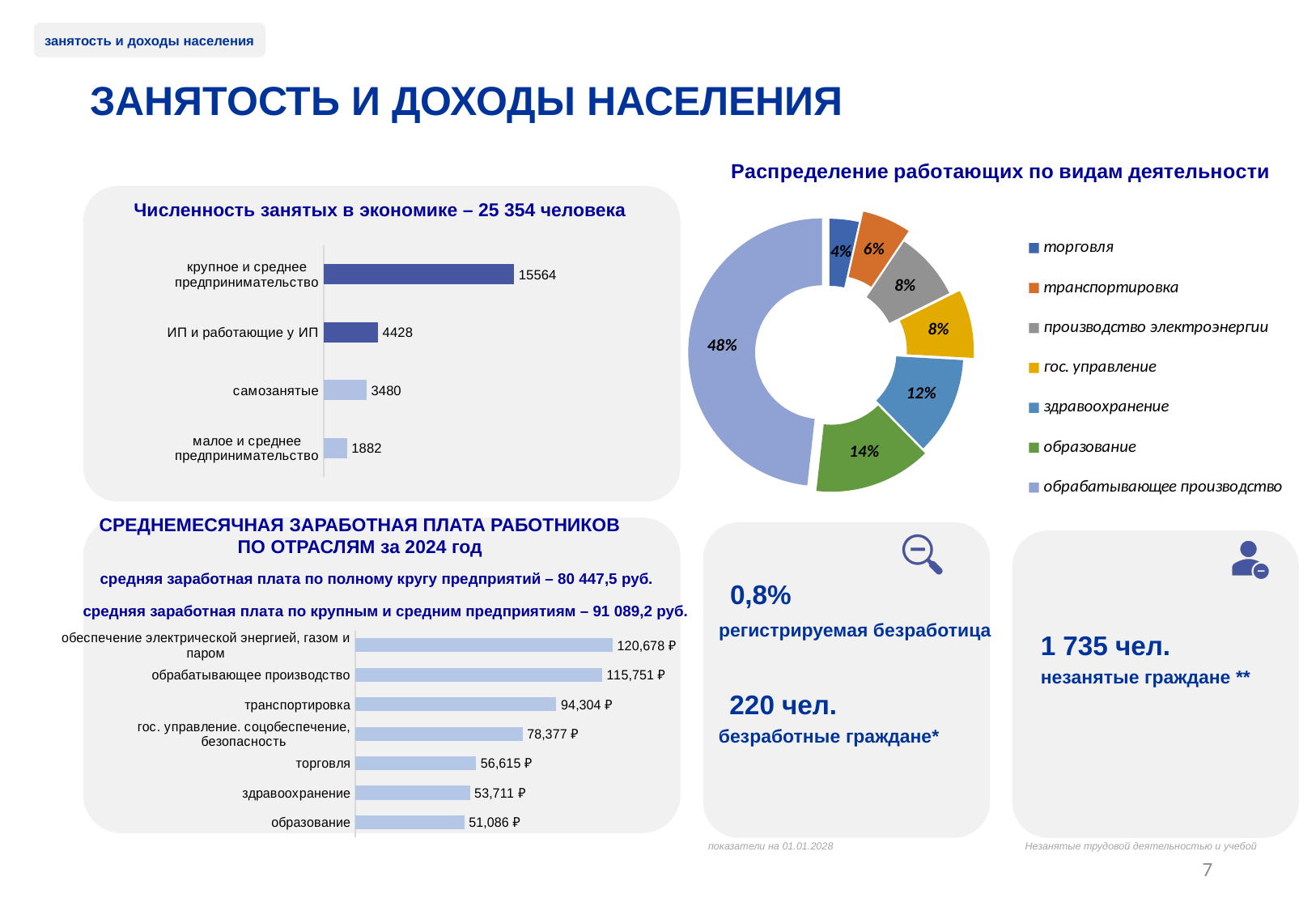
In the chart 'Численность занятых в экономике – 25 354 человека', what is the value for 'ИП и работающие у ИП'? 4428 How many categories are shown in the chart 'Численность занятых в экономике – 25 354 человека'? 4 In the chart 'Среднемесячная заработная плата работников по отраслям за 2024 год', which is larger: 'торговля' or 'здравоохранение'? торговля In the chart 'Распределение работающих по видам деятельности', which category has the smallest share? торговля In the chart 'Численность занятых в экономике – 25 354 человека', which category has the highest value? крупное и среднее предпринимательство In the chart 'Распределение работающих по видам деятельности', what share does 'образование' have? 14% In the chart 'Численность занятых в экономике – 25 354 человека', what is the difference between 'самозанятые' and 'малое и среднее предпринимательство'? 1598 In the chart 'Среднемесячная заработная плата работников по отраслям за 2024 год', what is the value for 'транспортировка'? 94,304 ₽ In the chart 'Среднемесячная заработная плата работников по отраслям за 2024 год', which category has the lowest value? образование How many entries does the legend of the chart 'Распределение работающих по видам деятельности' list? 7 What kind of chart is 'Среднемесячная заработная плата работников по отраслям за 2024 год'? bar chart What kind of chart is 'Распределение работающих по видам деятельности'? doughnut chart